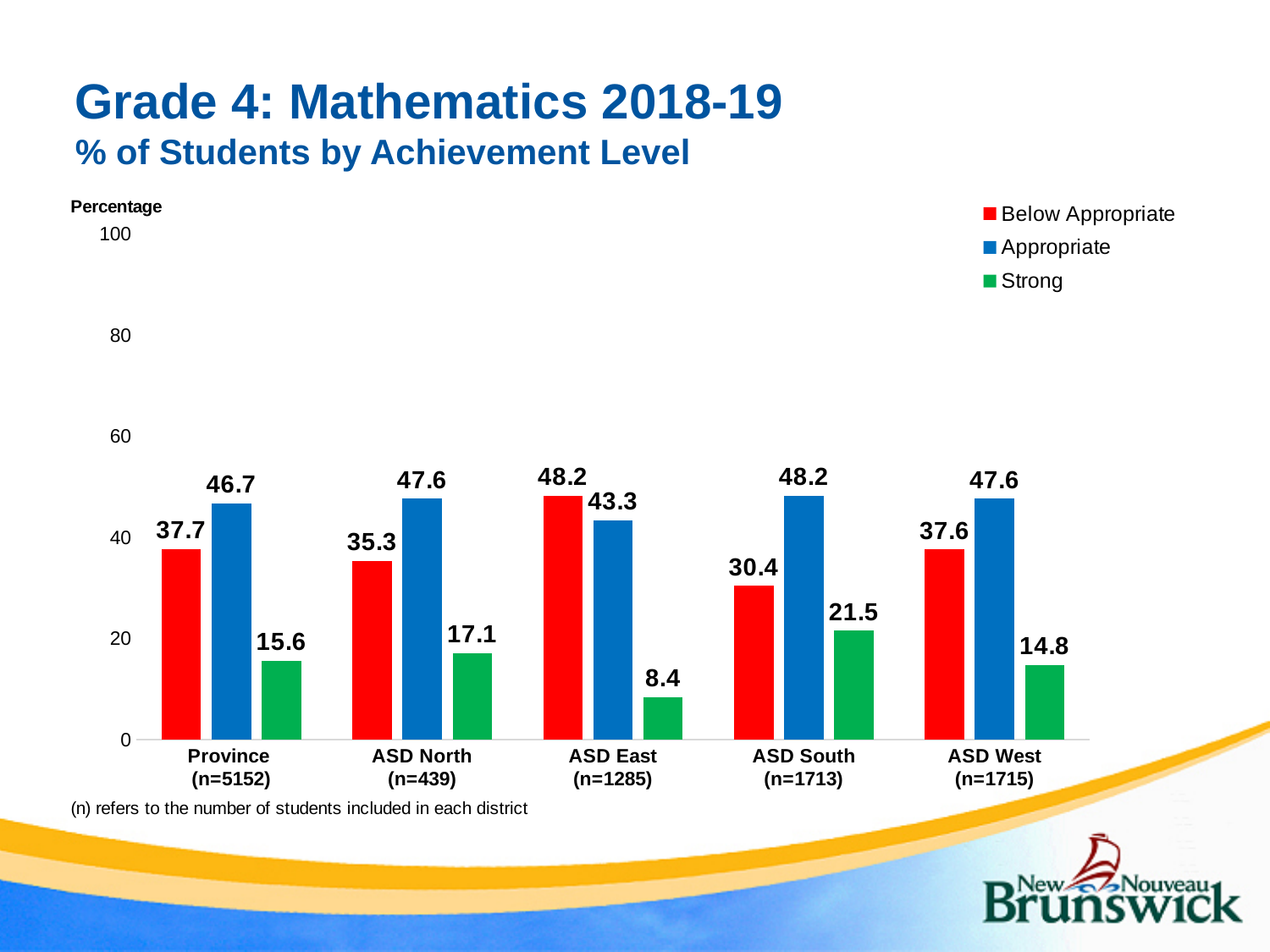
What is the difference between the Strong percentages for ASD South and ASD East? 13.1 How many series does the legend list? 3 What is the Appropriate percentage for the Province? 46.7 What percentage of students in ASD East are at the Below Appropriate level? 48.2 What is the Strong percentage for ASD South? 21.5 Is the Appropriate value for ASD East greater or less than 40? greater Which district has the lowest Strong percentage? ASD East What kind of chart is shown on the slide? bar chart Which is larger: the Below Appropriate percentage for ASD North or for ASD West? ASD West How many categories (districts including Province) are shown on the x axis? 5 Which district has the highest Strong percentage? ASD South Which category has the lowest Below Appropriate percentage? ASD South